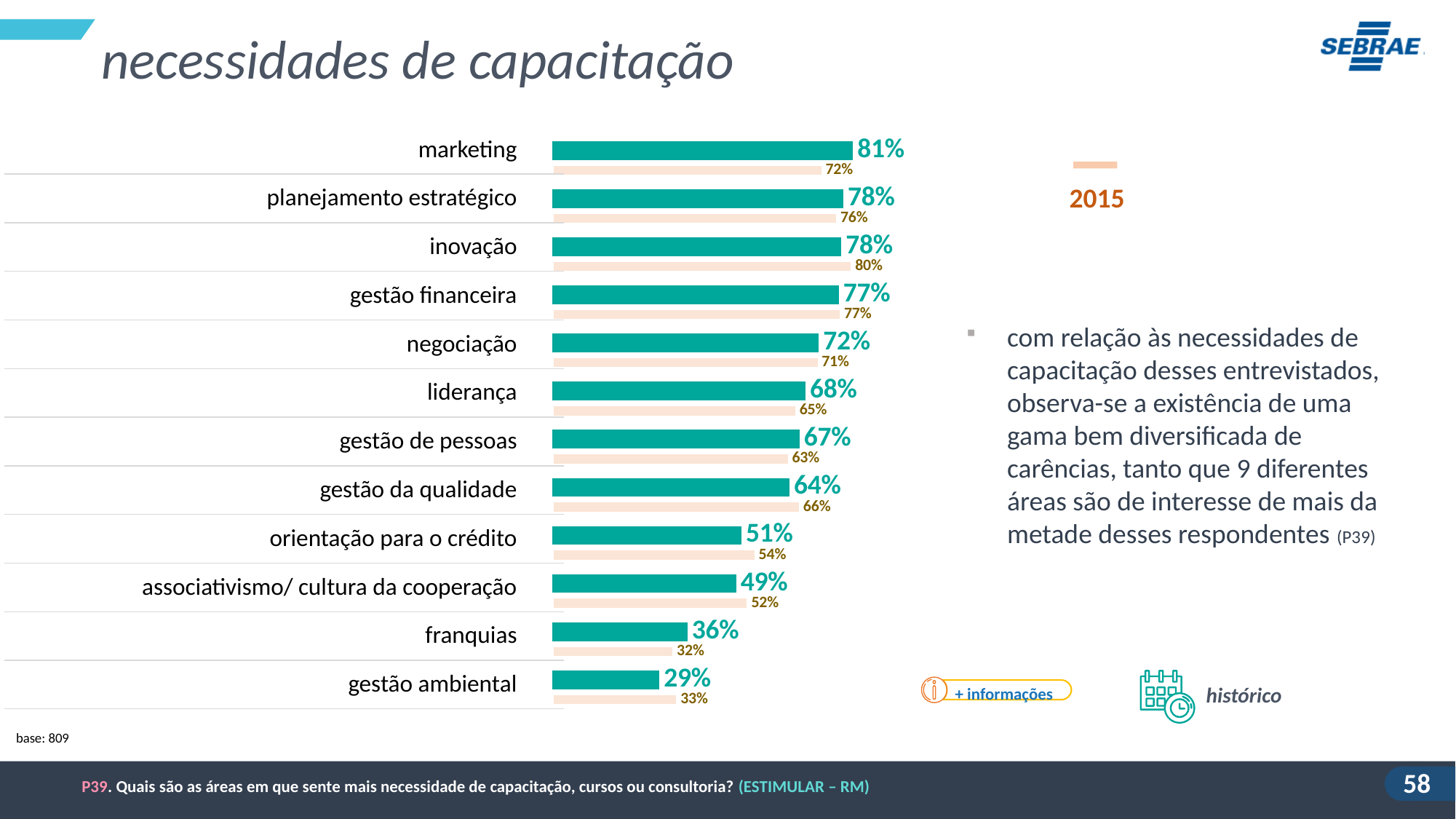
What is the value of the teal bar for marketing? 81% What is the 2015 value for gestão ambiental? 33% What is the difference between the teal value and the 2015 value for franquias? 4 percentage points Which category has the lowest teal bar value? gestão ambiental For inovação, which is larger: the teal bar value or the 2015 value? the 2015 value What is the difference between the teal value and the 2015 value for marketing? 9 percentage points What is the 2015 value for inovação? 80% Which category has the highest teal bar value? marketing Which year is labelled in the legend for the light peach bars? 2015 How many categories are shown in the chart? 12 Which has a higher teal bar value: negociação or liderança? negociação What type of chart is shown on the slide? bar chart